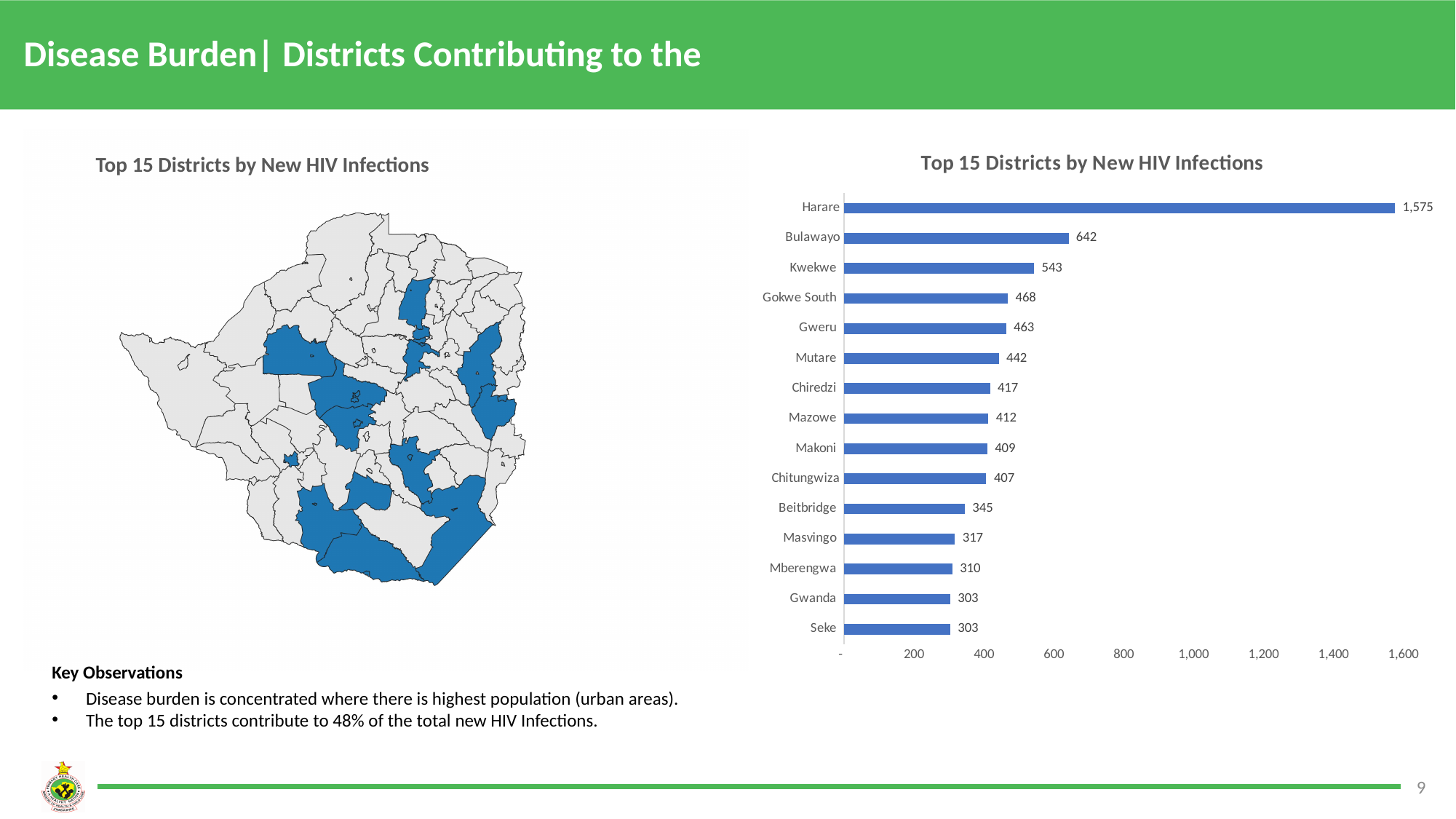
In the bar chart 'Top 15 Districts by New HIV Infections', which district has the highest value? Harare In the bar chart 'Top 15 Districts by New HIV Infections', which is larger, Gokwe South or Mutare? Gokwe South What kind of chart is 'Top 15 Districts by New HIV Infections' on the right of the slide? bar chart In the bar chart 'Top 15 Districts by New HIV Infections', what is the difference between Beitbridge and Masvingo? 28 In the bar chart 'Top 15 Districts by New HIV Infections', what is the value for Chitungwiza? 407 In the bar chart 'Top 15 Districts by New HIV Infections', what is the lowest value shown? 303 How many districts are shown in the bar chart 'Top 15 Districts by New HIV Infections'? 15 In the bar chart 'Top 15 Districts by New HIV Infections', what is the value for Harare? 1,575 In the bar chart 'Top 15 Districts by New HIV Infections', is the value for Bulawayo greater or less than 600? greater In the bar chart 'Top 15 Districts by New HIV Infections', what is the highest tick value on the horizontal axis? 1,600 In the bar chart 'Top 15 Districts by New HIV Infections', what is the difference between Harare and Bulawayo? 933 In the bar chart 'Top 15 Districts by New HIV Infections', what is the value for Kwekwe? 543